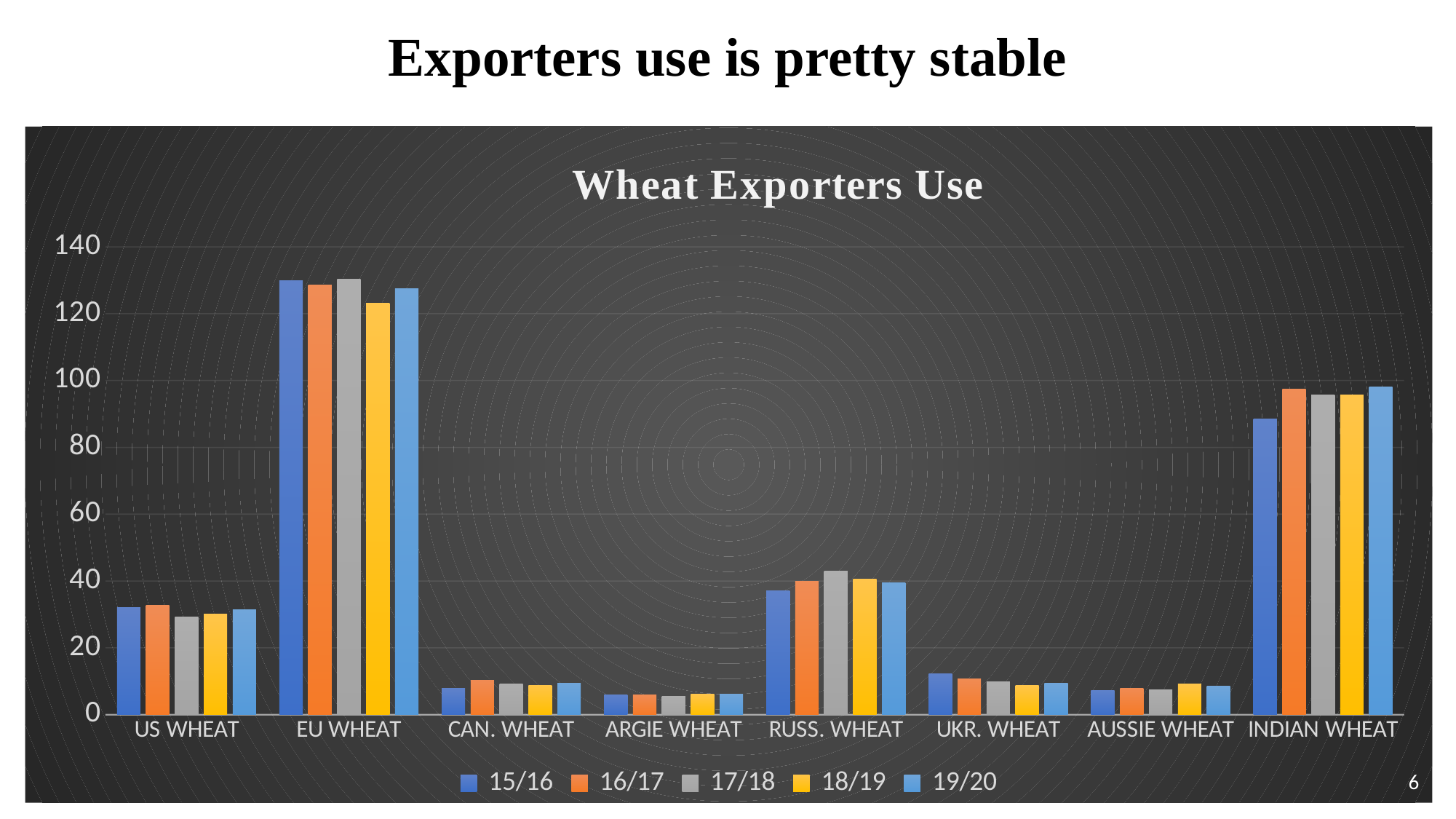
Is the value for US WHEAT in 15/16 greater or less than 20? greater What kind of chart is shown on the slide? bar chart How many wheat categories are shown on the x axis? 8 What is the title of the chart? Wheat Exporters Use Is the value for EU WHEAT in 15/16 greater or less than 120? greater For the 19/20 series, which is larger: EU WHEAT or INDIAN WHEAT? EU WHEAT For the 15/16 series, which is larger: US WHEAT or RUSS. WHEAT? RUSS. WHEAT How many series does the legend list? 5 Which category has the highest values across all series? EU WHEAT Which category has the lowest value for the 18/19 series? ARGIE WHEAT Is the value for UKR. WHEAT in 15/16 greater or less than 20? less